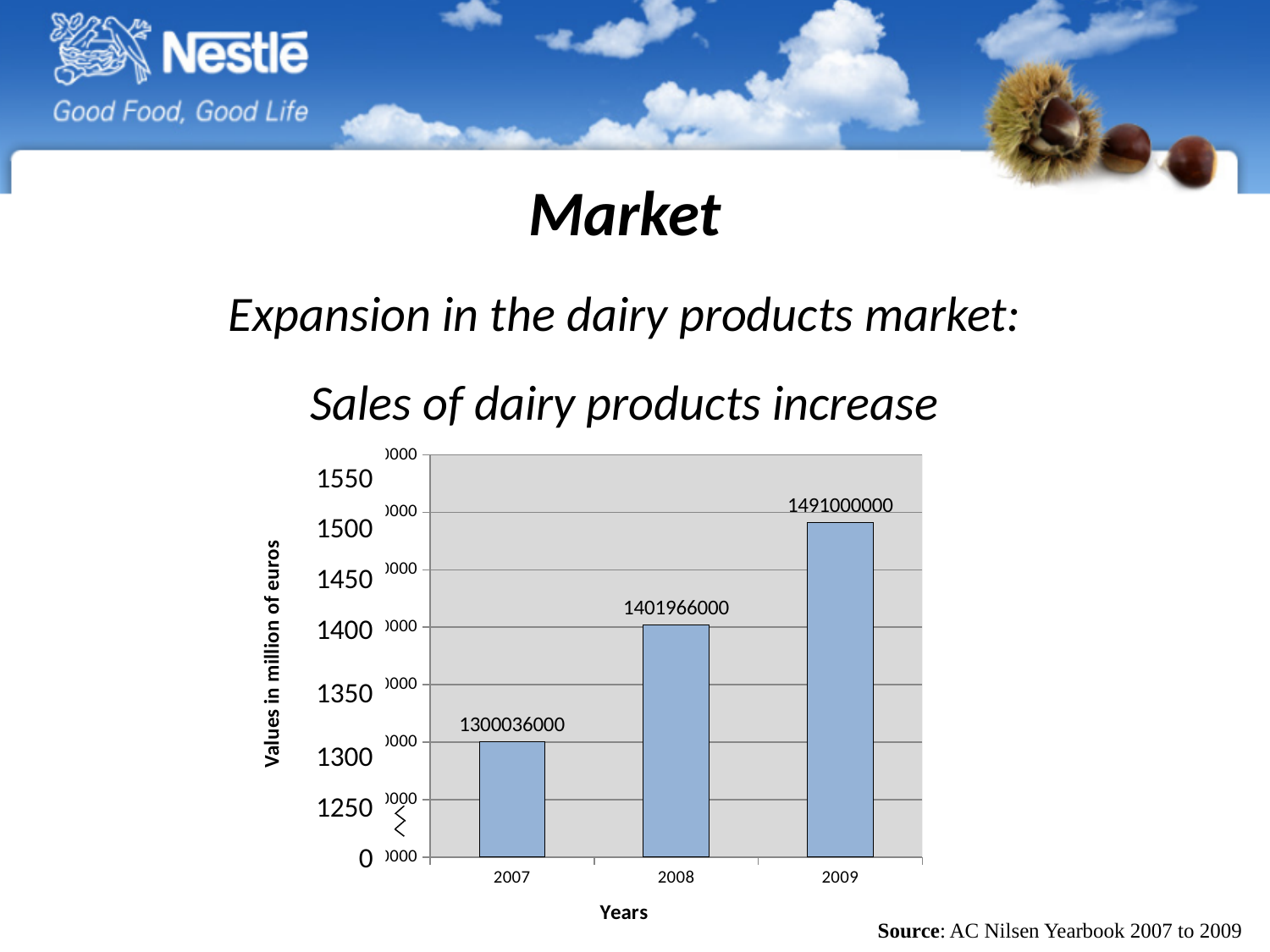
What kind of chart is shown? bar chart What is the value for 2008? 1401966000 Do the values rise or fall from 2007 to 2009? rise What is the value for 2009? 1491000000 Which year has the lowest value? 2007 What is the difference between the values for 2009 and 2008? 89034000 What is the value for 2007? 1300036000 Which year has the highest value? 2009 Which is larger, the value for 2008 or the value for 2009? 2009 What is the difference between the values for 2008 and 2007? 101930000 Is the value for 2007 greater or less than 1350 on the axis? less How many years are shown on the x axis? 3